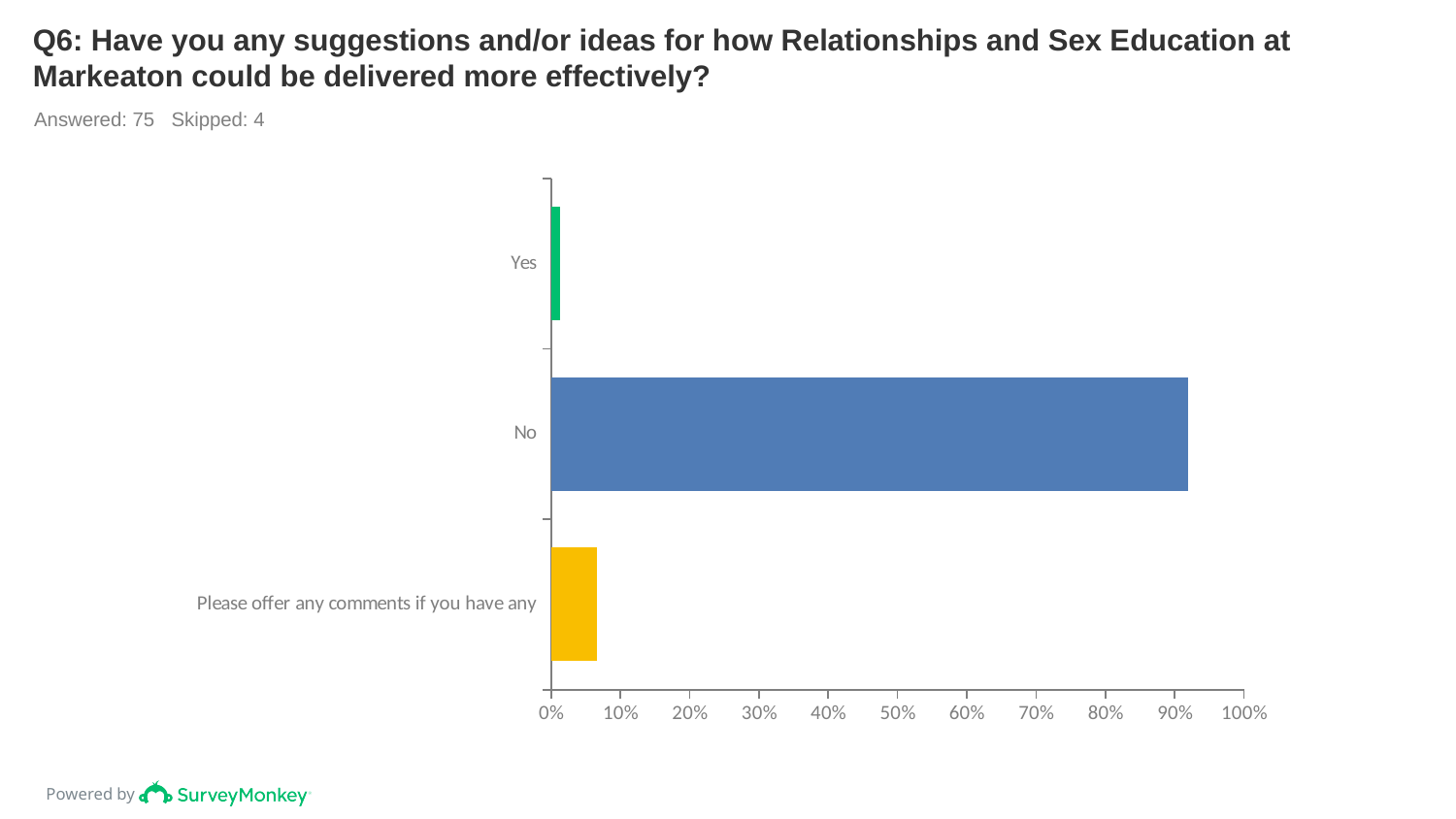
Which is larger, the value for Yes or the value for "Please offer any comments if you have any"? Please offer any comments if you have any What kind of chart is shown on the slide? bar chart Is the value for No greater or less than 80%? greater How many categories are plotted in the chart? 3 Which category has the highest value? No Is the value for No greater or less than 50%? greater Is the value for "Please offer any comments if you have any" greater or less than 10%? less What colour is the bar for No? blue Which is larger, the value for No or the value for Yes? No How many respondents answered this question according to the slide? 75 Which category has the lowest value? Yes